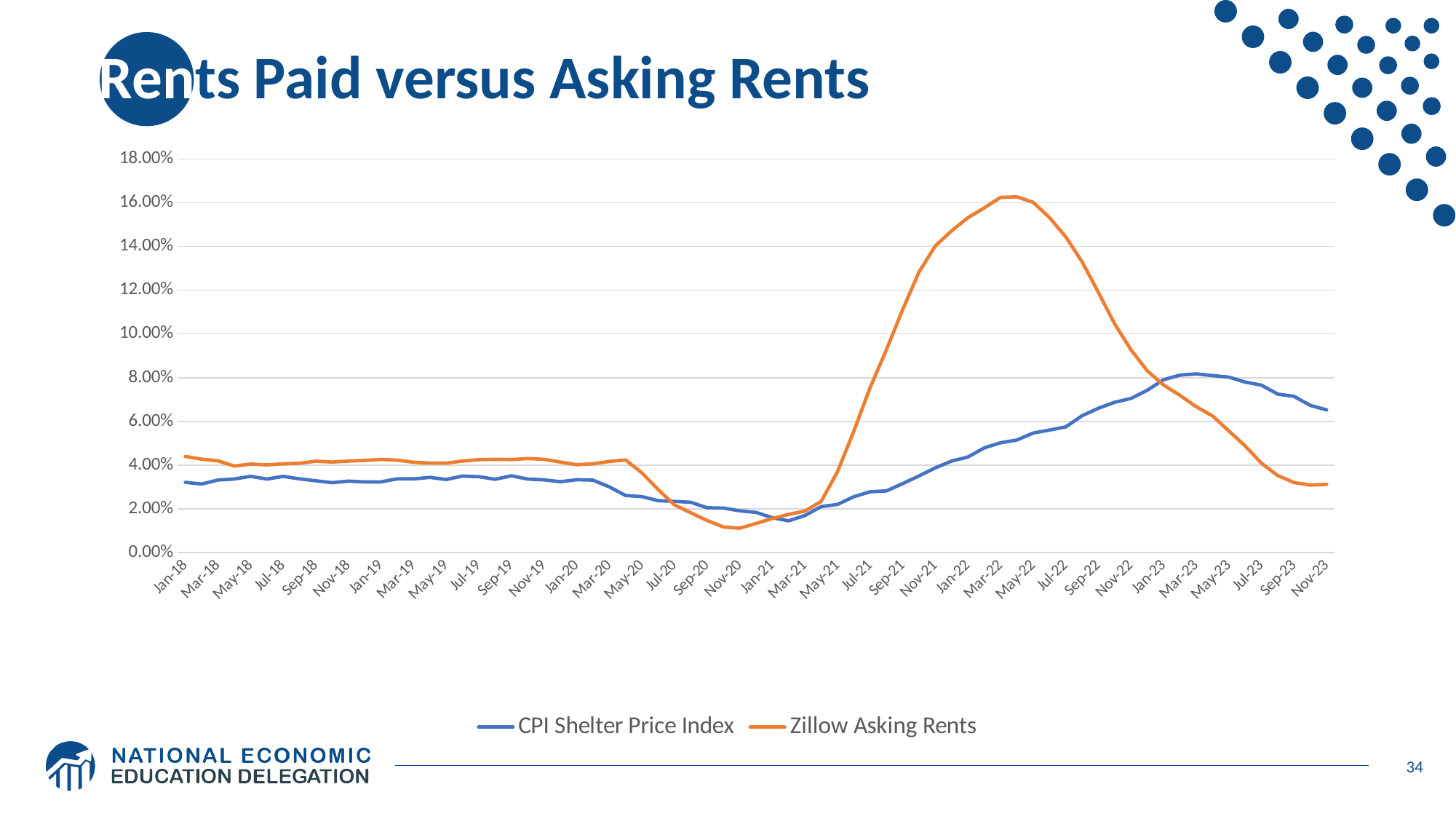
What is the title of the chart on the slide? Rents Paid versus Asking Rents Around which month does the Zillow Asking Rents line reach its lowest point? Nov-20 What kind of chart is shown on the slide? Line chart Which series is drawn in orange? Zillow Asking Rents Does the Zillow Asking Rents line rise or fall between Mar-22 and Nov-23? Fall At Mar-23, which series has the higher value, CPI Shelter Price Index or Zillow Asking Rents? CPI Shelter Price Index Is the value of the CPI Shelter Price Index at Mar-23 greater or less than 6.00%? greater How many series does the legend list? 2 Which series reaches the highest value on the chart? Zillow Asking Rents Is the value of Zillow Asking Rents at Nov-20 greater or less than 2.00%? less Is the value of Zillow Asking Rents at Mar-22 greater or less than 14.00%? greater